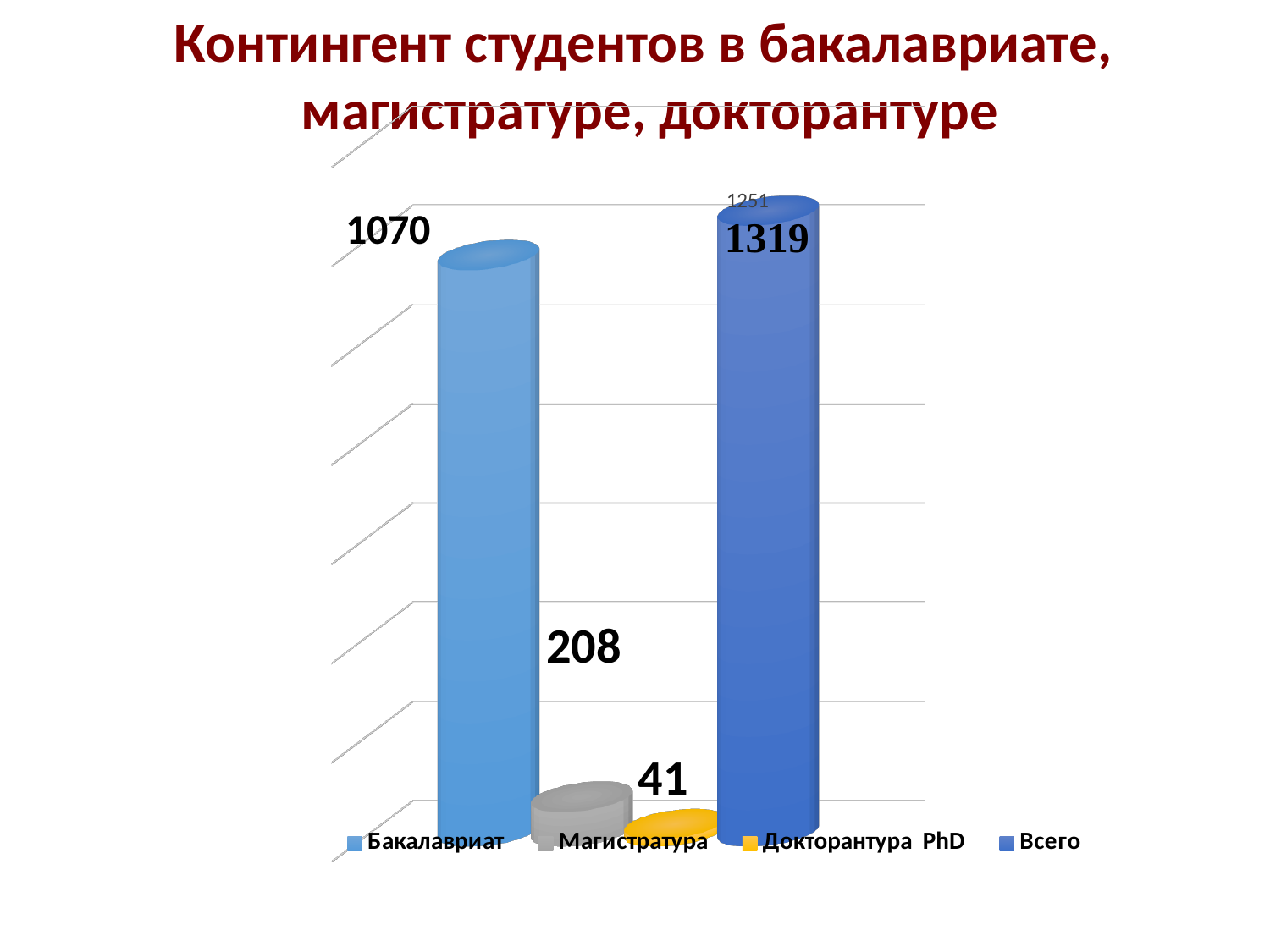
How many series does the legend list? 4 Which is larger, the value for Бакалавриат or the value for Магистратура? Бакалавриат Which series has the lowest value? Докторантура PhD What is the difference between the values for Бакалавриат and Магистратура? 862 Which series has the highest bar? Всего What is the value shown for Магистратура? 208 What colour is the bar for Докторантура PhD? Yellow What is the value shown for Докторантура PhD? 41 What is the value shown for Бакалавриат? 1070 What is the difference between the values for Магистратура and Докторантура PhD? 167 What kind of chart is shown on the slide? Bar chart What is the title of the slide? Контингент студентов в бакалавриате, магистратуре, докторантуре